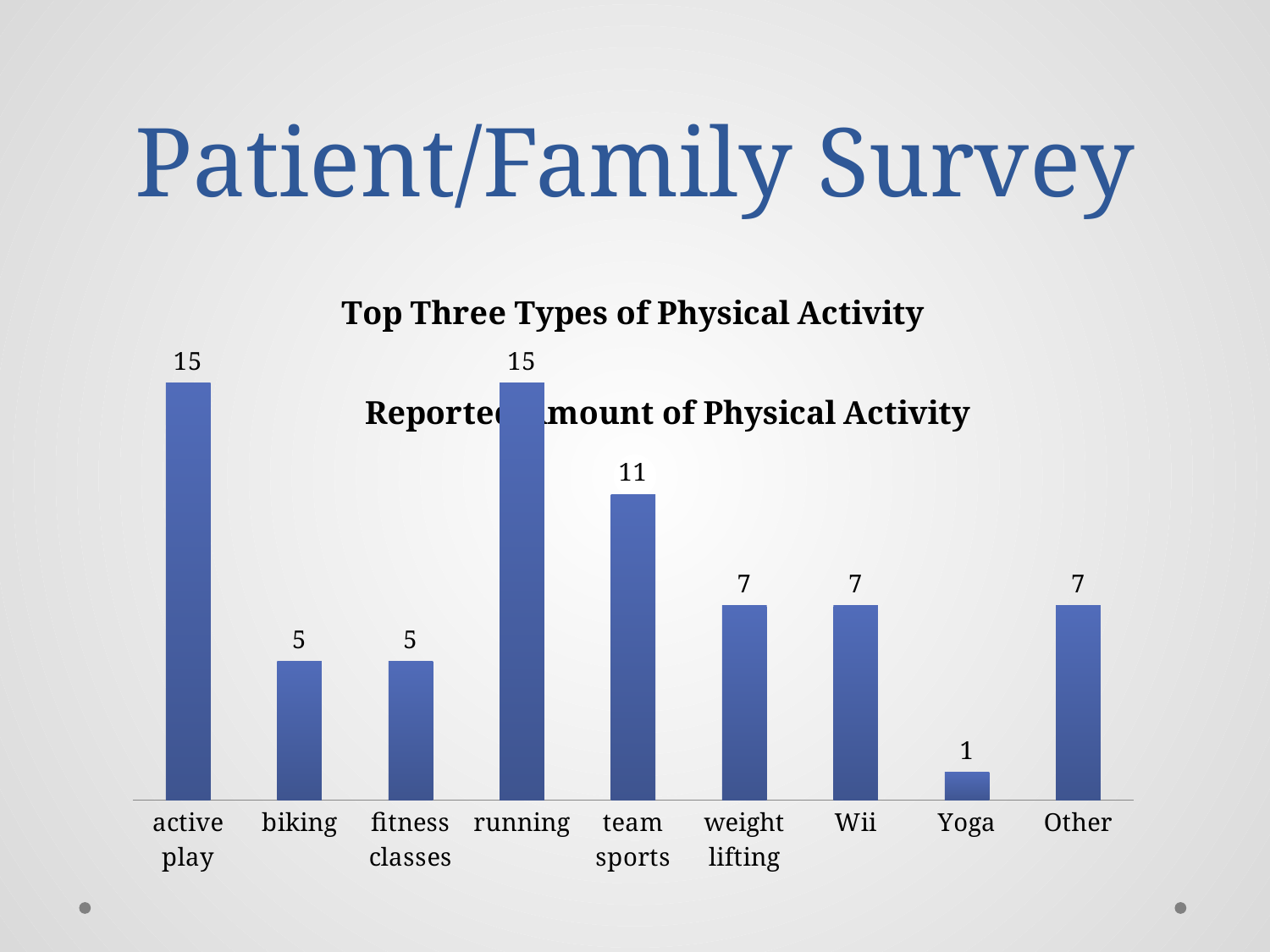
What is the value for team sports? 11 What is the value for Yoga? 1 What kind of chart is shown on the slide? bar chart How many categories are shown on the x axis? 9 What is the value for running? 15 What is the difference between the values for weight lifting and Yoga? 6 What is the title of the chart? Top Three Types of Physical Activity Which is larger, the value for fitness classes or the value for Other? Other What is the value for biking? 5 Which category has the lowest value? Yoga What is the difference between the values for running and team sports? 4 Which is larger, the value for team sports or the value for Wii? team sports